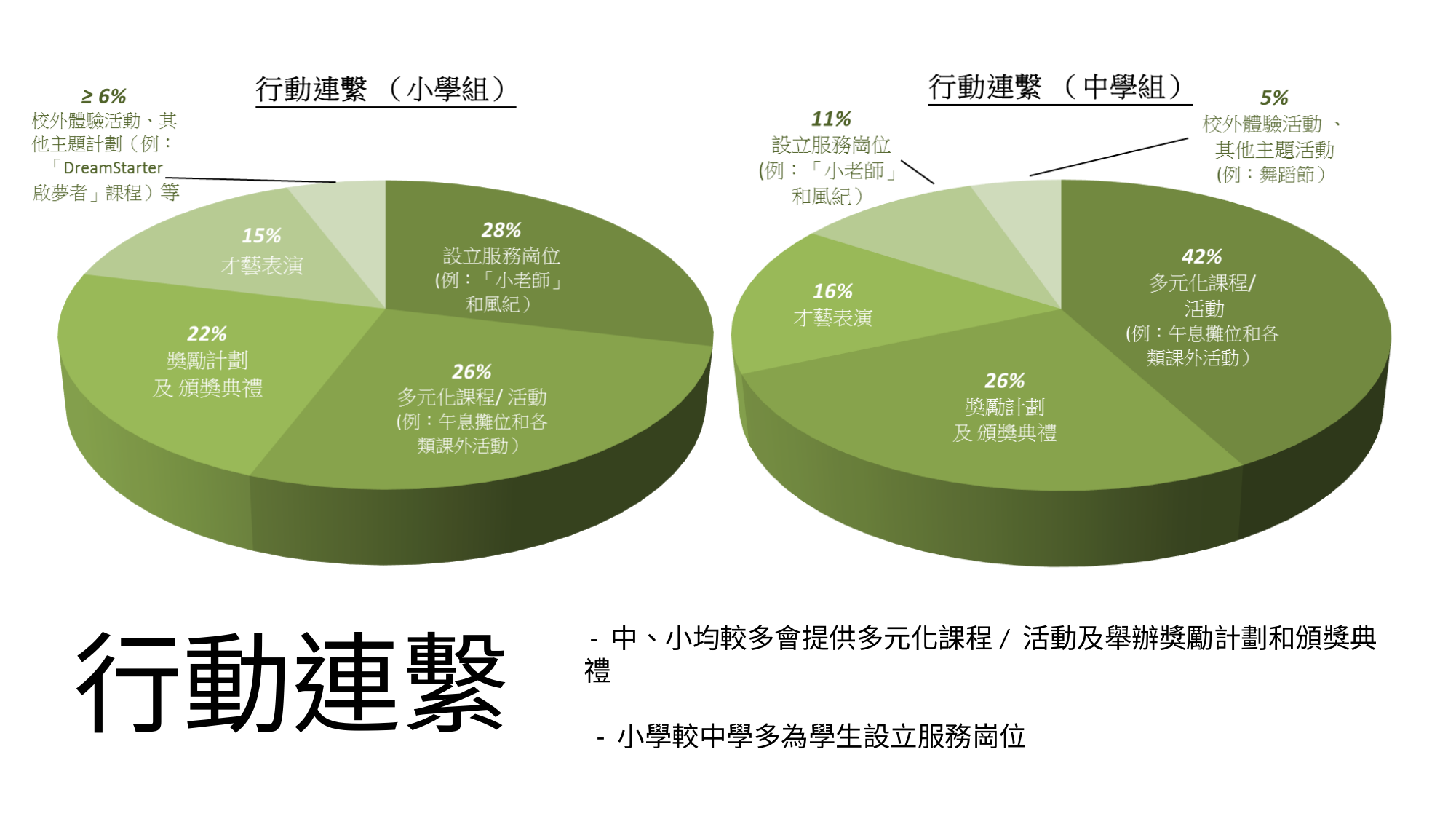
In the 行動連繫（小學組） chart, how many slices does the pie have? 5 In the 行動連繫（小學組） chart, what share is 設立服務崗位? 28% In the 行動連繫（中學組） chart, what share is 設立服務崗位? 11% In the 行動連繫（小學組） chart, what is the difference between 設立服務崗位 and 獎勵計劃及頒獎典禮? 6% In the 行動連繫（小學組） chart, what share is 才藝表演? 15% In the 行動連繫（小學組） chart, which category has the largest share? 設立服務崗位 In the 行動連繫（中學組） chart, what is the difference between 多元化課程/活動 and 獎勵計劃及頒獎典禮? 16% In the 行動連繫（中學組） chart, which is larger, 才藝表演 or 設立服務崗位? 才藝表演 What type of chart is the 行動連繫（中學組） chart? Pie chart In the 行動連繫（中學組） chart, which category has the smallest share? 校外體驗活動、其他主題活動 What is the title of the chart on the left of the slide? 行動連繫（小學組） In the 行動連繫（中學組） chart, what share is 多元化課程/活動? 42%